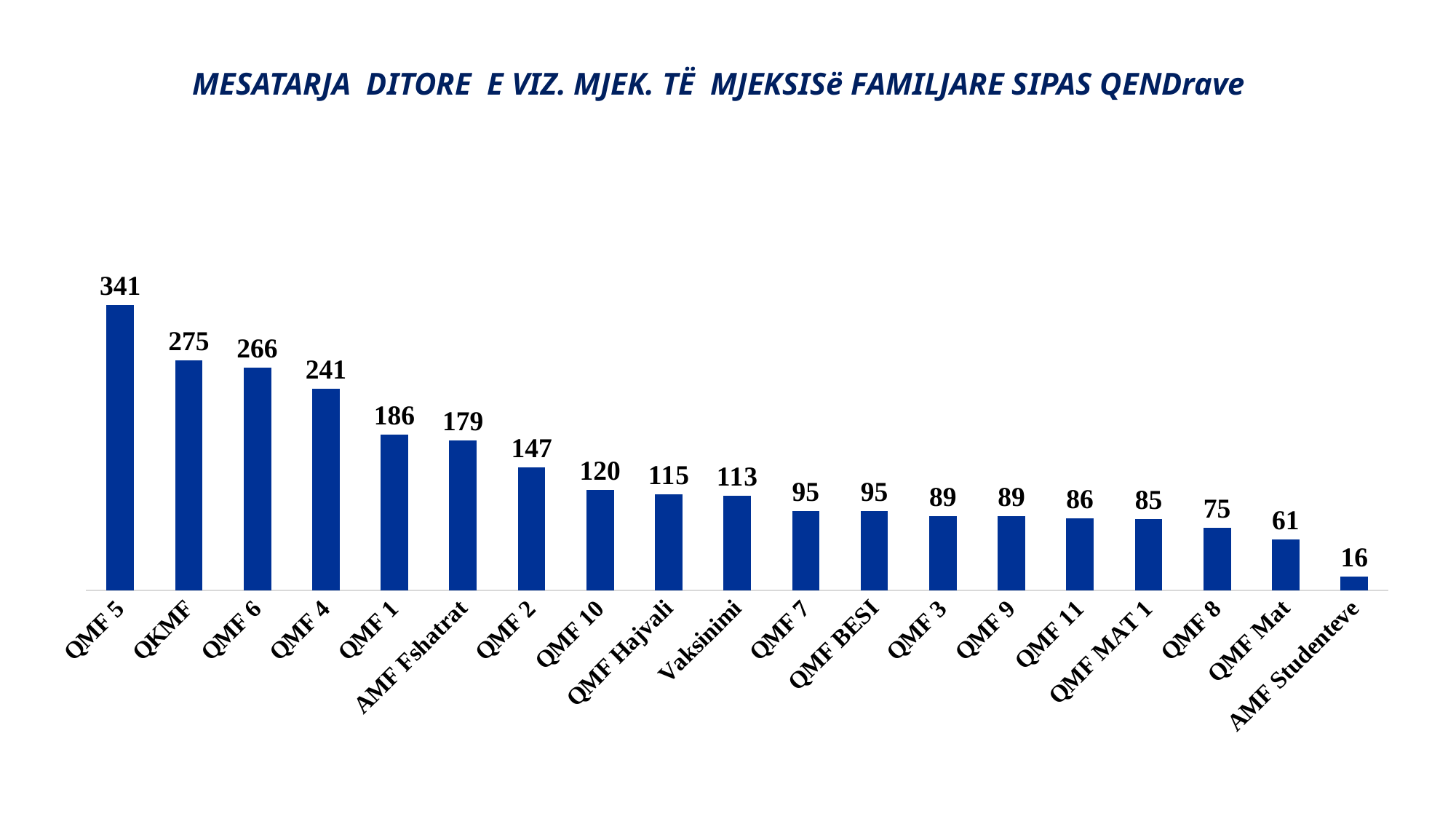
What is the value for AMF Fshatrat? 179 Which category has the lowest value? AMF Studenteve Do the values rise or fall from left to right along the x axis? Fall Which is larger, the value for QMF 2 or the value for QMF 10? QMF 2 What is the value for QMF 5? 341 Which category has the highest value? QMF 5 What kind of chart is shown on the slide? Bar chart How many categories are shown in the chart? 19 What is the difference between the values for QKMF and QMF 6? 9 What is the value for QMF Hajvali? 115 What is the value for QMF Mat? 61 What is the difference between the values for QMF 5 and AMF Studenteve? 325